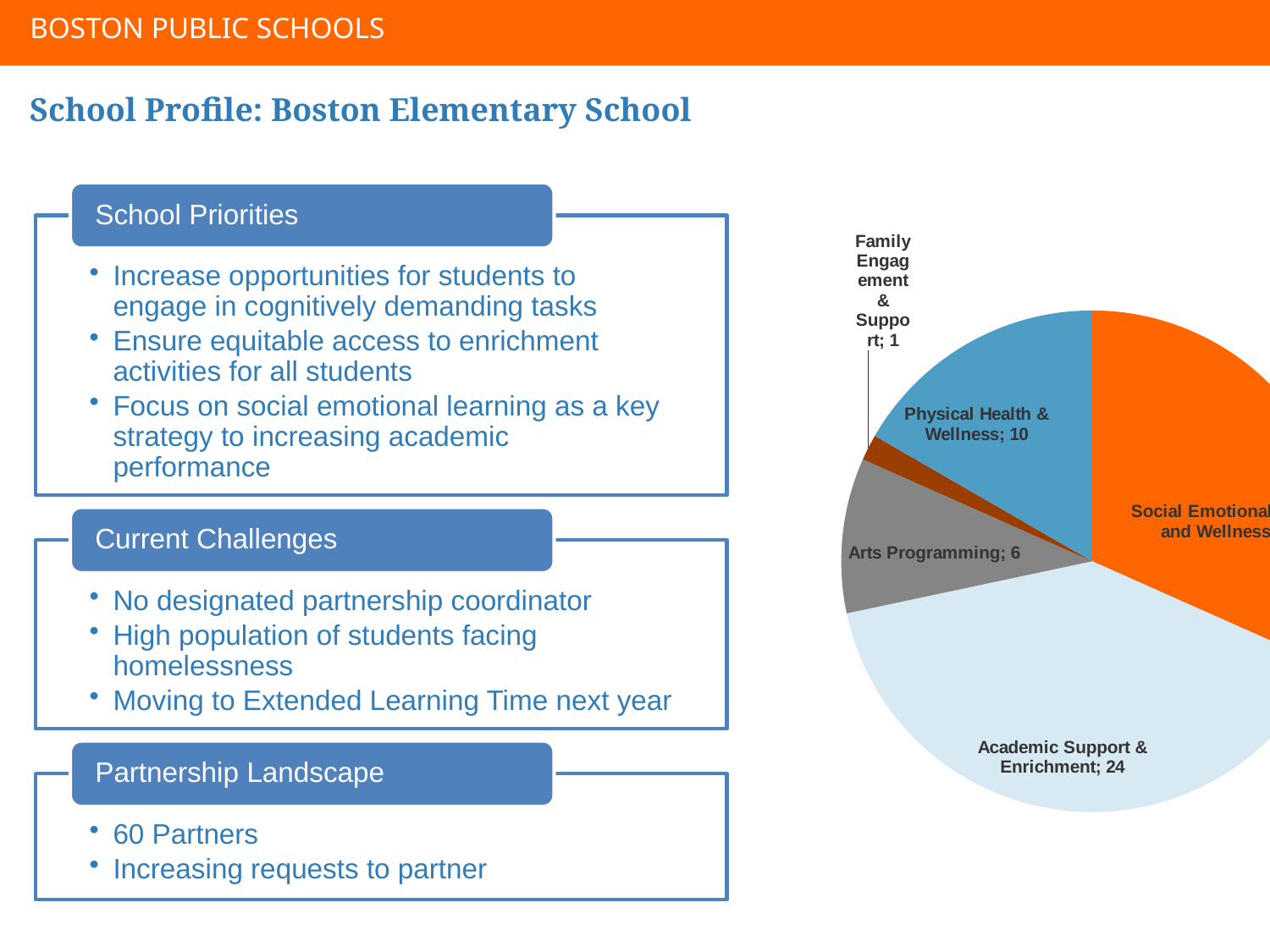
Which category has the smallest slice in the pie chart? Family Engagement & Support What is the value for Academic Support & Enrichment in the pie chart? 24 What is the value for Arts Programming in the pie chart? 6 What is the difference between the values for Academic Support & Enrichment and Physical Health & Wellness? 14 What is the value for Physical Health & Wellness in the pie chart? 10 What colour is the Social Emotional and Wellness slice in the pie chart? orange What kind of chart is shown on the right side of the slide? pie chart Which is larger in the pie chart, Physical Health & Wellness or Arts Programming? Physical Health & Wellness Which category has the largest slice in the pie chart? Academic Support & Enrichment What is the value for Family Engagement & Support in the pie chart? 1 How many slices does the pie chart have? 5 What is the difference between the values for Physical Health & Wellness and Arts Programming? 4